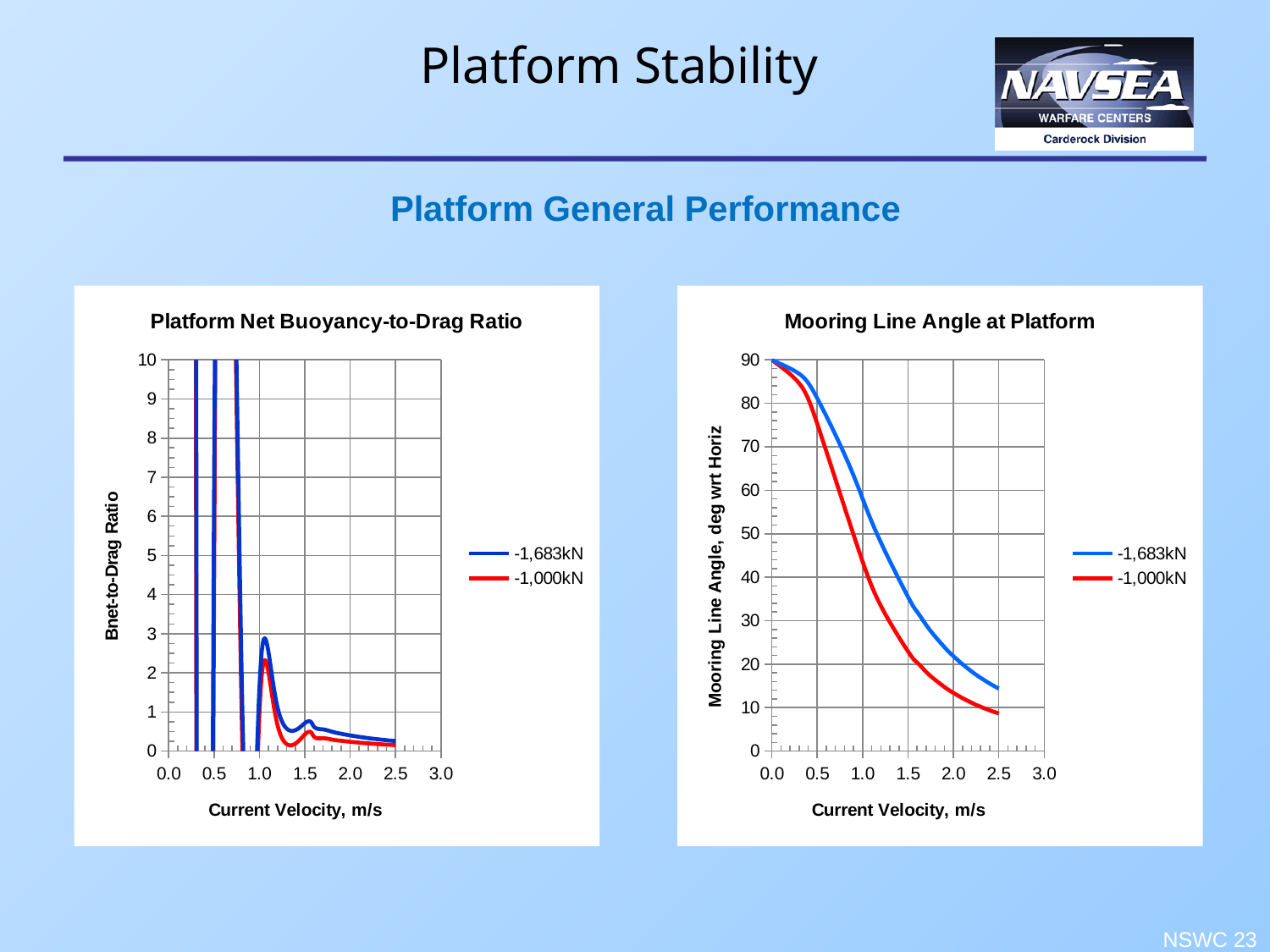
In the 'Mooring Line Angle at Platform' chart, is the value for -1,683kN at 1.0 m/s greater or less than 50? greater What is the x-axis label of the 'Platform Net Buoyancy-to-Drag Ratio' chart? Current Velocity, m/s In the 'Mooring Line Angle at Platform' chart, do the values rise or fall as current velocity increases? fall How many series does the legend of the 'Platform Net Buoyancy-to-Drag Ratio' chart list? 2 In the 'Mooring Line Angle at Platform' chart, what is the mooring line angle at a current velocity of 0.0 m/s? 90 In the 'Mooring Line Angle at Platform' chart, is the value for -1,000kN at 2.0 m/s greater or less than 20? less In the 'Mooring Line Angle at Platform' chart, which series has the larger angle at 1.0 m/s, -1,683kN or -1,000kN? -1,683kN In the 'Mooring Line Angle at Platform' chart, which colour is used for the -1,000kN series? red In the 'Platform Net Buoyancy-to-Drag Ratio' chart, is the value for -1,000kN at 2.5 m/s greater or less than 1? less In the 'Platform Net Buoyancy-to-Drag Ratio' chart, which series reaches the higher peak near 1.0 m/s, -1,683kN or -1,000kN? -1,683kN What kind of chart is the 'Mooring Line Angle at Platform' chart? line chart